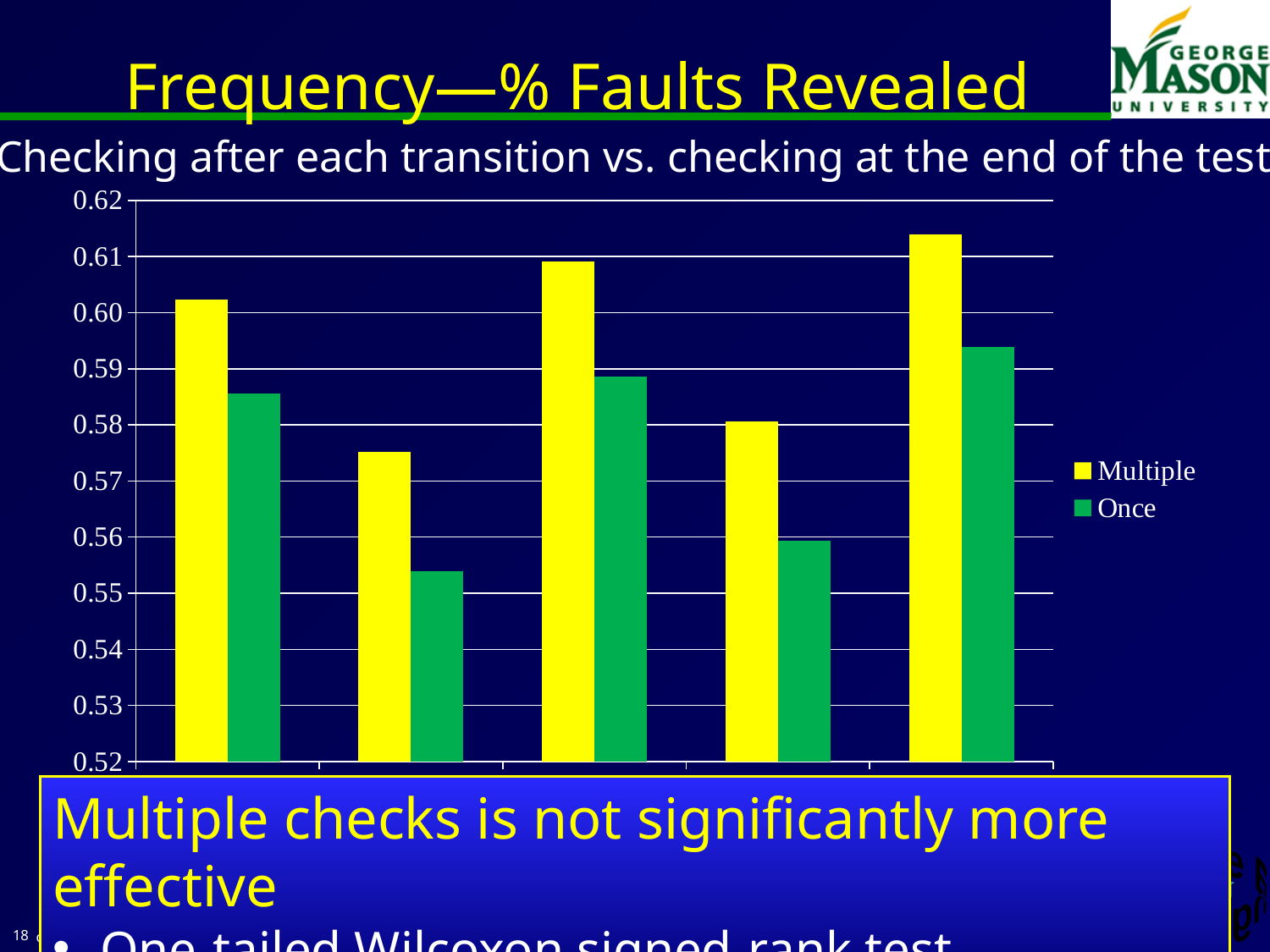
Which group of bars (counting from the left) has the lowest Once value? the second group What kind of chart is shown on the slide? bar chart How many series does the chart legend list? 2 Is the Once value in the second group from the left greater or less than 0.56? less In the first group of bars from the left, which series has the larger value, Multiple or Once? Multiple Is the Multiple value in the fifth group from the left greater or less than 0.61? greater In the fourth group of bars from the left, which series has the larger value, Multiple or Once? Multiple Which group of bars (counting from the left) has the highest Multiple value? the fifth group What are the two series named in the chart legend? Multiple and Once How many groups of bars are plotted in the chart? 5 Is the Once value in the fourth group from the left greater or less than 0.57? less Which colour represents the Multiple series in the chart? yellow